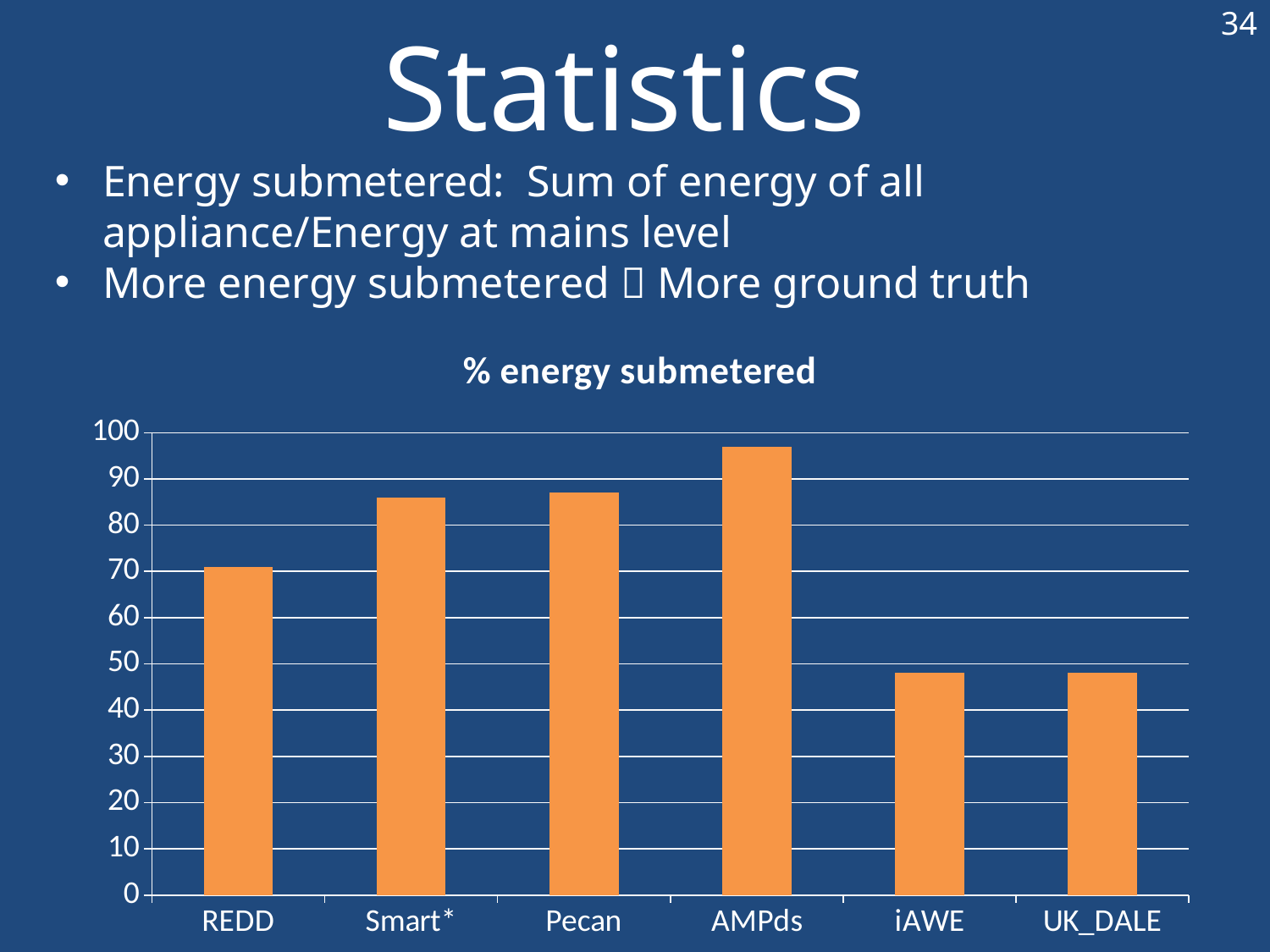
Which has a higher % energy submetered, REDD or Pecan? Pecan What kind of chart is shown on the slide? bar chart Is the value for iAWE greater or less than 60? less Which has a higher % energy submetered, Smart* or iAWE? Smart* How many datasets (categories) are shown on the x axis of the chart? 6 Is the value for AMPds greater or less than 90? greater Which has a higher % energy submetered, REDD or AMPds? AMPds What is the title of the chart? % energy submetered Is the value for Smart* greater or less than 80? greater Which dataset has the highest % energy submetered? AMPds